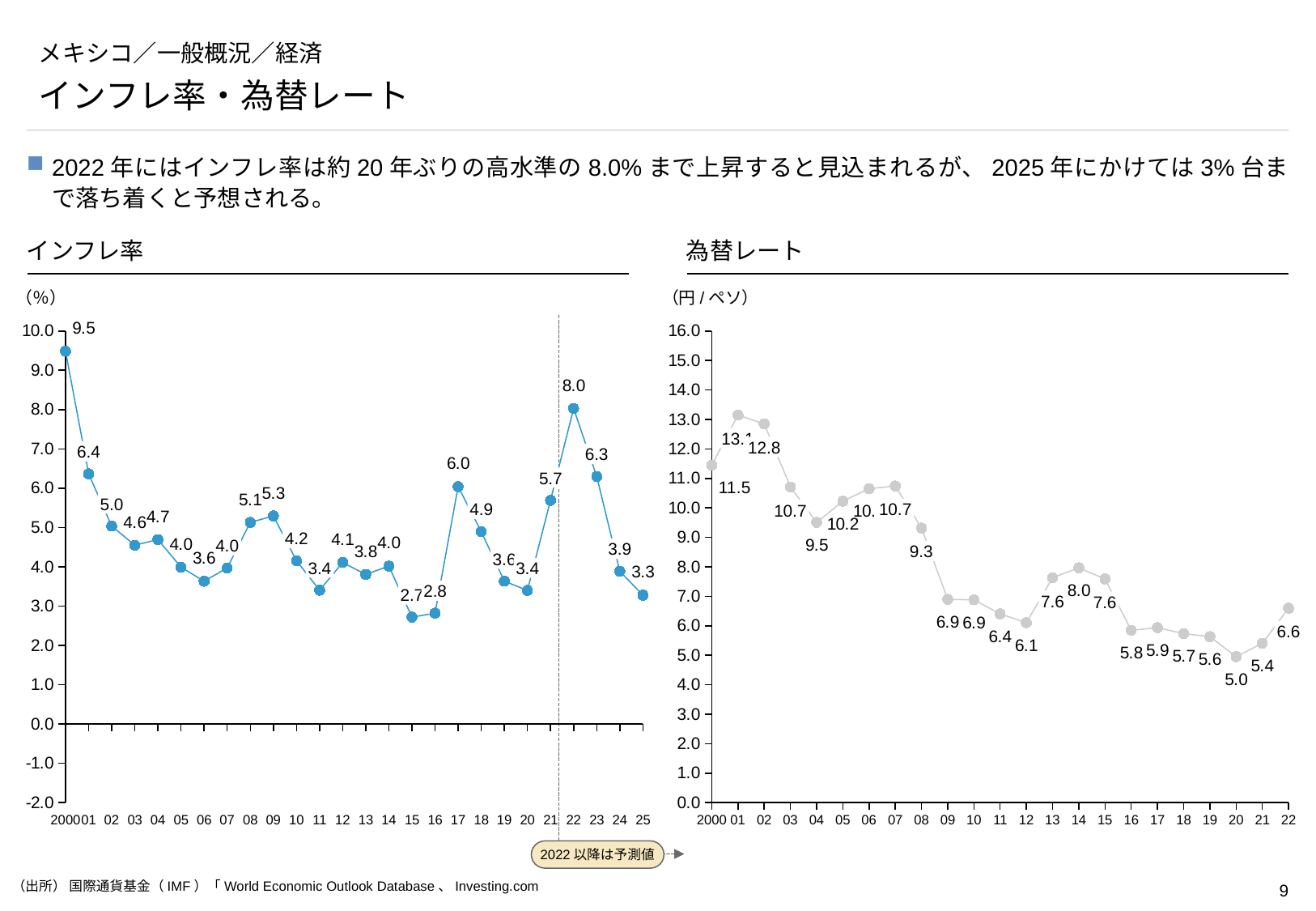
What kind of chart is the 為替レート chart? line chart In the インフレ率 chart, which is larger, the value for 2017 or the value for 2021? 2017 In the 為替レート chart, what is the value for 2020? 5.0 In the 為替レート chart, do the values generally rise or fall from 2000 to 2020? fall In the インフレ率 chart, what is the difference between the 2022 value and the 2025 value? 4.7 In the インフレ率 chart, how many years are plotted? 26 In the インフレ率 chart, what is the value for 2000? 9.5 In the 為替レート chart, what is the difference between the 2001 value and the 2002 value? 0.3 What unit is shown on the y axis of the 為替レート chart? 円/ペソ In the 為替レート chart, which year has the highest value? 2001 In the インフレ率 chart, which year has the lowest inflation rate? 2015 In the インフレ率 chart, what is the inflation rate for 2022? 8.0